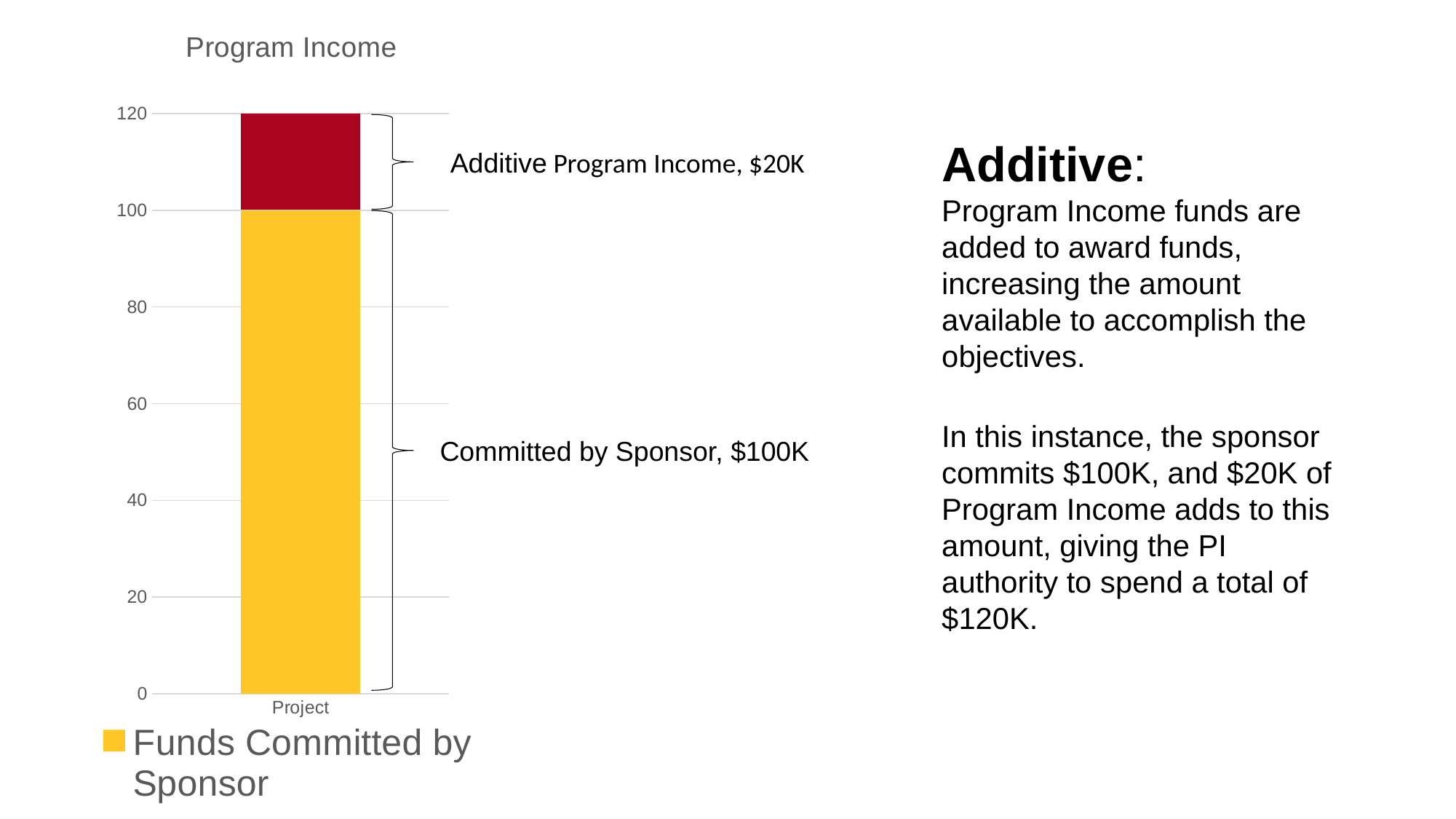
What is the total height of the stacked bar for Project? 120 What kind of chart is shown on the slide? stacked bar chart How many entries does the chart's legend list? 1 What is the amount labelled as Committed by Sponsor? $100K What is the highest value shown on the y axis? 120 What is the title of the chart? Program Income Is the total of the stacked bar for Project greater or less than 100? greater Which segment of the bar is larger, Committed by Sponsor or Additive Program Income? Committed by Sponsor What is the label of the category on the x axis? Project What is the difference between the Committed by Sponsor amount and the Additive Program Income amount? $80K What is the amount labelled as Additive Program Income? $20K How many categories are shown on the x axis of the chart? 1